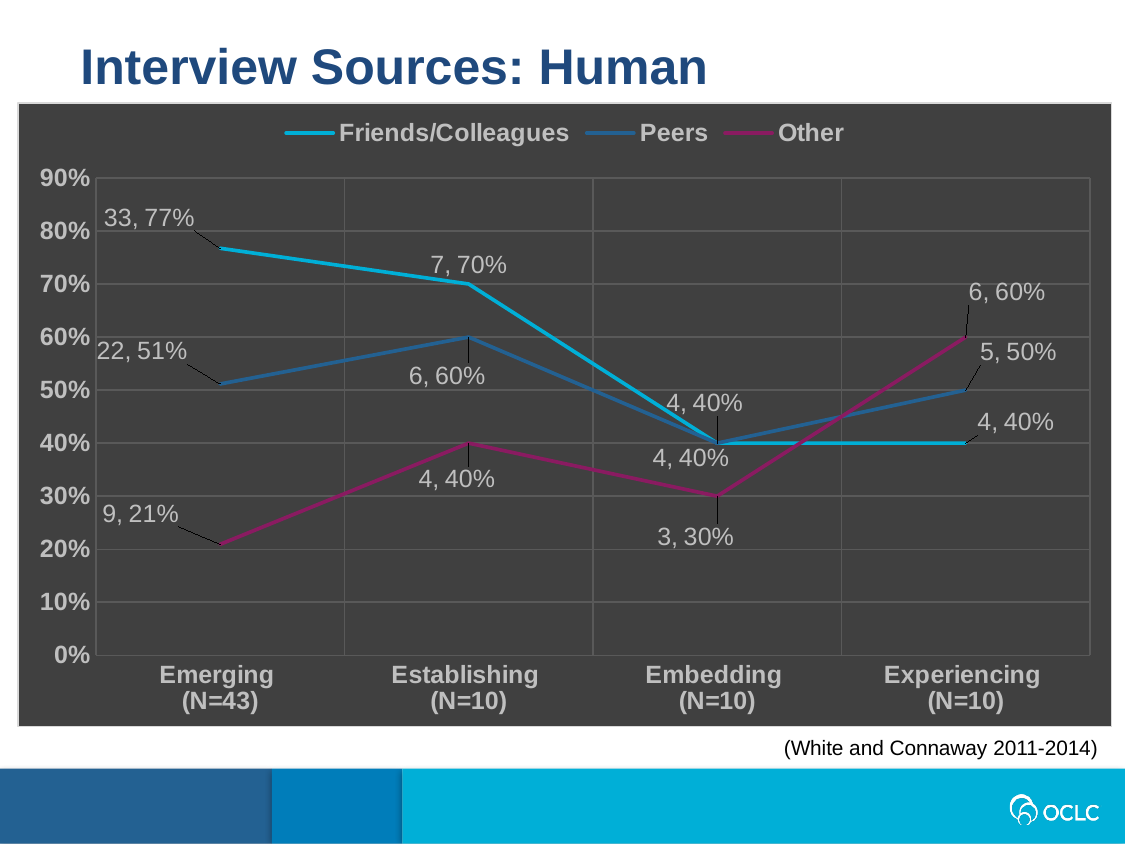
In which category is the Friends/Colleagues value highest? Emerging (N=43) What is the percentage for Peers in the Establishing (N=10) category? 60% How many categories are shown on the x axis? 4 What is the percentage for Friends/Colleagues in the Emerging (N=43) category? 77% How many series does the legend list? 3 What is the difference in percentage points between Friends/Colleagues and Other in the Emerging (N=43) category? 56 In which category is the Other value lowest? Emerging (N=43) What is the percentage for Other in the Experiencing (N=10) category? 60% In the Experiencing (N=10) category, which series has the larger value, Peers or Friends/Colleagues? Peers What kind of chart is shown on the slide? Line chart What is the percentage for Other in the Embedding (N=10) category? 30% Does the Friends/Colleagues line rise or fall from Emerging to Embedding? Fall